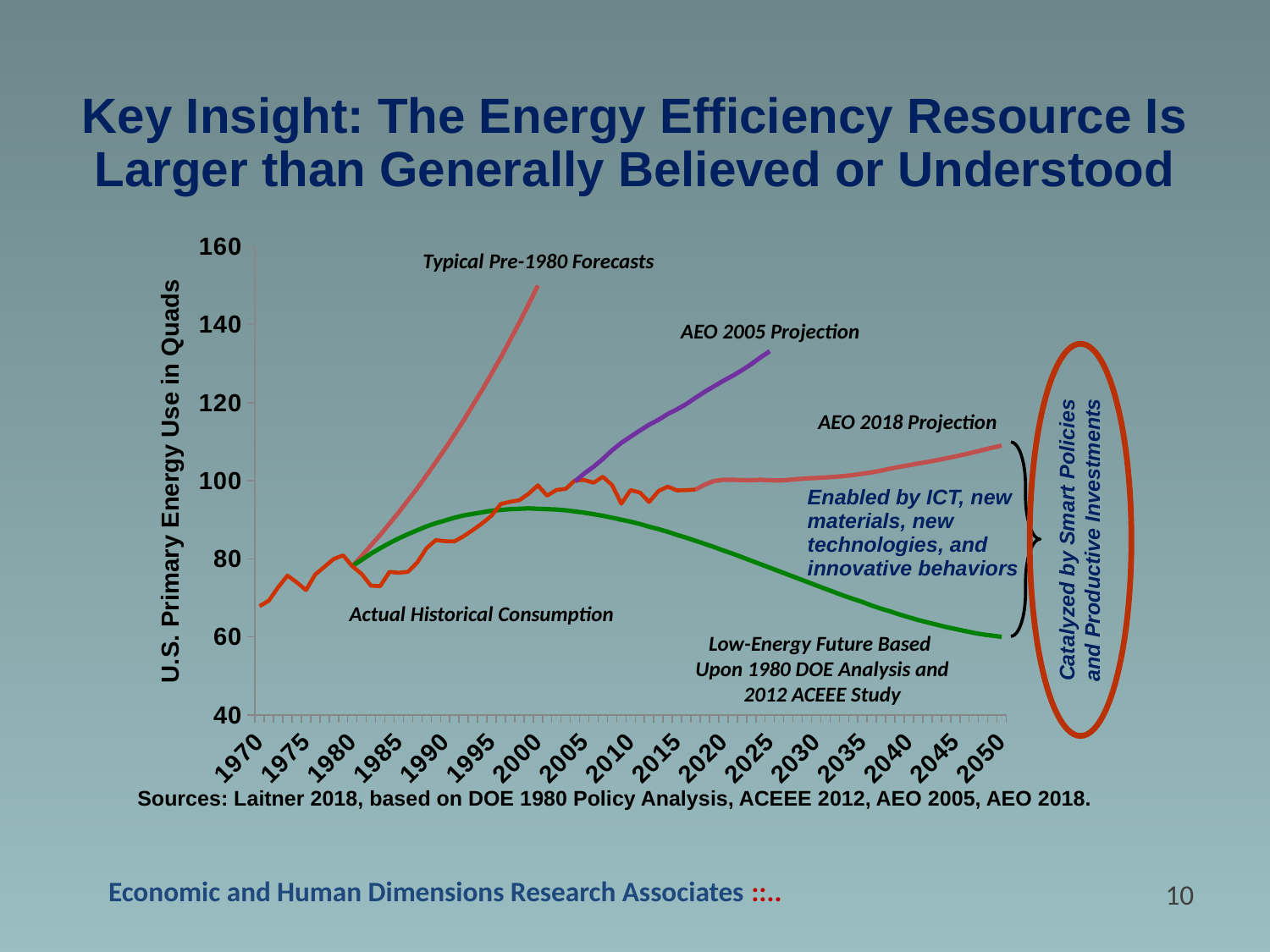
Does the Low-Energy Future line rise or fall between 2000 and 2050? fall Is the value of the Typical Pre-1980 Forecasts line in 2000 greater or less than 140? greater Is the value of the AEO 2018 Projection line in 2050 greater or less than 100? greater What kind of chart is shown on the slide? line chart What is the label of the vertical axis? U.S. Primary Energy Use in Quads How many labeled lines (series) are plotted on the chart? 5 Is the value of the Actual Historical Consumption line in 1970 greater or less than 80? less In 2050, which line is higher: the AEO 2018 Projection or the Low-Energy Future line? AEO 2018 Projection What is the last year shown on the horizontal axis? 2050 Does the Typical Pre-1980 Forecasts line rise or fall between 1980 and 2000? rise